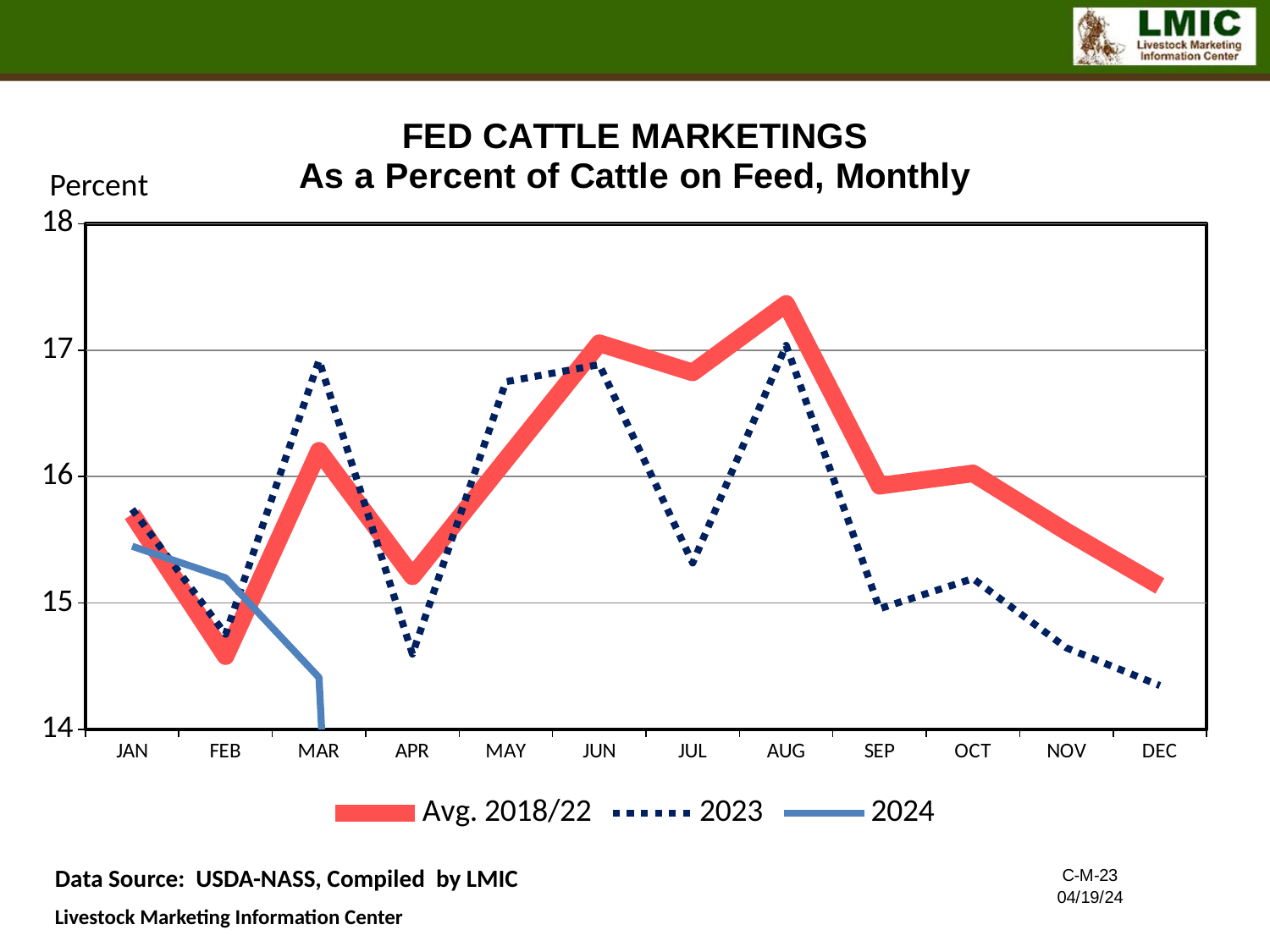
How many series does the legend list? 3 Is the 2024 value for JAN greater or less than 15? greater In which month does the Avg. 2018/22 series reach its lowest value? FEB In JUL, which series has the larger value, Avg. 2018/22 or 2023? Avg. 2018/22 In MAR, which series has the larger value, Avg. 2018/22 or 2023? 2023 How many months are shown on the x axis? 12 Is the 2023 value for DEC greater or less than 15? less Does the 2024 series rise or fall from JAN to MAR? fall Is the Avg. 2018/22 value for AUG greater or less than 17? greater In which month does the Avg. 2018/22 series reach its highest value? AUG What type of chart is shown on the slide? line chart